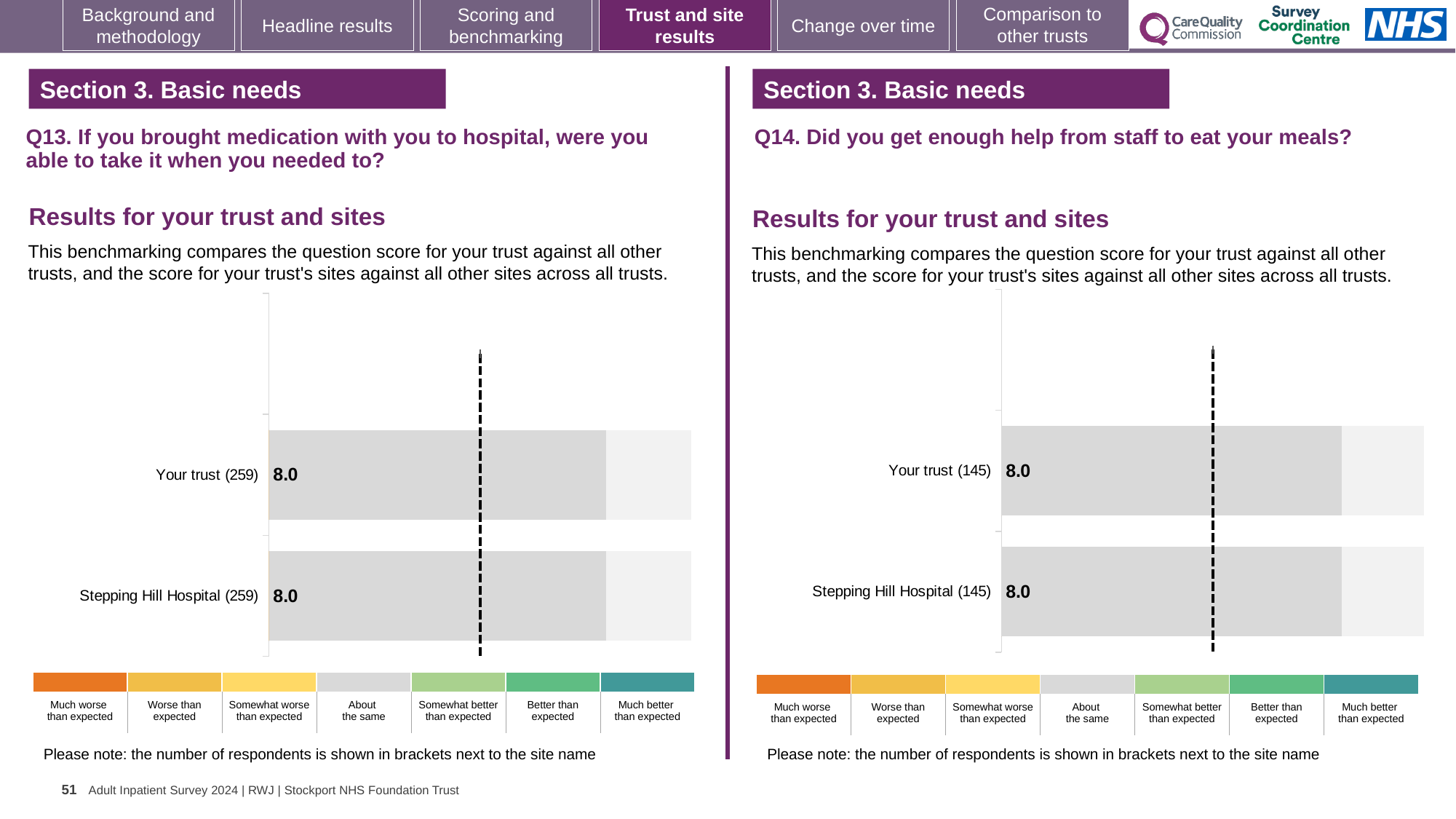
In the Q13 chart on the left, what is the difference between the score for Your trust and the score for Stepping Hill Hospital? 0.0 What kind of chart is the Q13 chart on the left? Bar chart In the Q13 chart on the left, what is the score for Your trust? 8.0 In the Q14 chart on the right, how many respondents are shown in brackets next to Stepping Hill Hospital? 145 In the Q14 chart on the right, what is the score for Your trust? 8.0 In the Q14 chart on the right, what is the difference between the score for Your trust and the score for Stepping Hill Hospital? 0.0 In the Q13 chart on the left, how many bars are plotted? 2 In the Q13 chart on the left, what is the score for Stepping Hill Hospital? 8.0 In the Q14 chart on the right, how many bars are plotted? 2 In the Q14 chart on the right, what is the score for Stepping Hill Hospital? 8.0 In the Q13 chart on the left, how many respondents are shown in brackets next to Your trust? 259